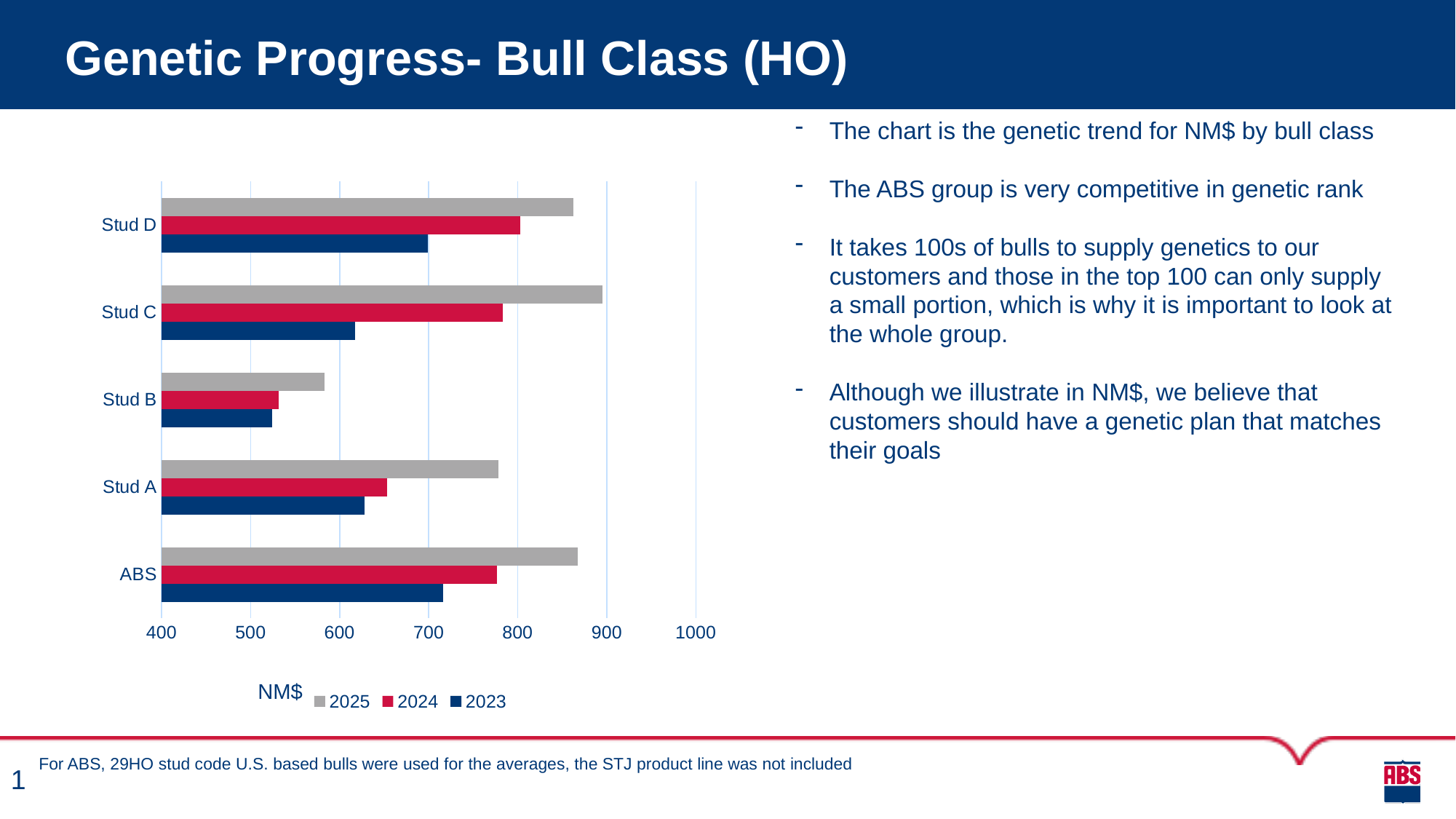
Which years are listed in the chart legend? 2025, 2024, 2023 Which bull class has the lowest 2025 value? Stud B Which bull class has the highest 2025 value? Stud C How many bull classes (categories) are shown on the chart? 5 What is the label shown on the horizontal axis of the chart? NM$ Which bull class has the lowest 2023 value? Stud B Is the 2025 value for Stud C greater or less than 800? greater How many series does the chart legend list? 3 Is the 2024 value for Stud A greater or less than 700? less Which is larger, the 2024 value for ABS or the 2024 value for Stud A? ABS What type of chart is shown on the slide? Bar chart Is the 2025 value for Stud B greater or less than 600? less